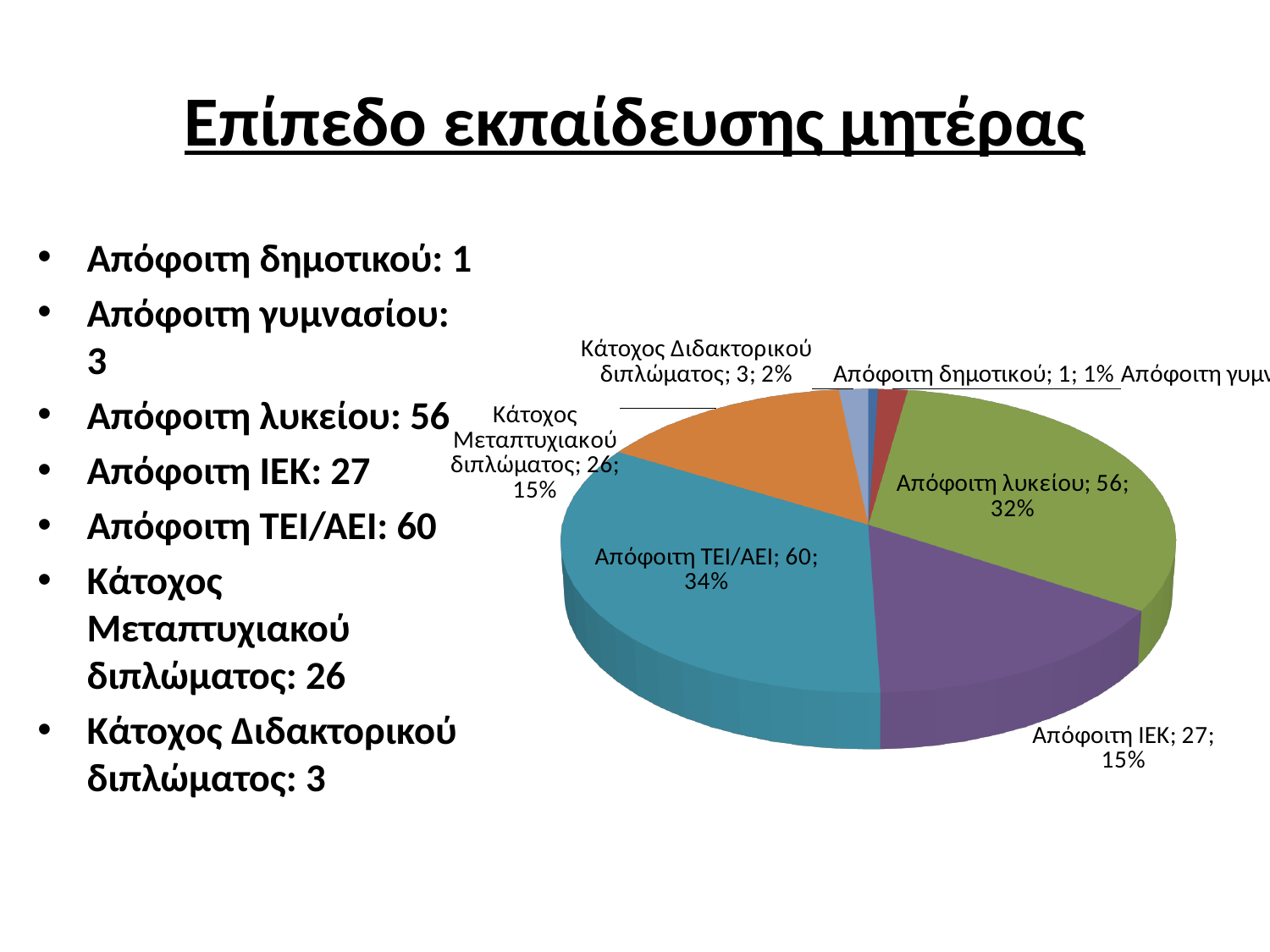
What is the value for Απόφοιτη ΤΕΙ/ΑΕΙ in the pie chart? 60 What percentage share does Κάτοχος Διδακτορικού διπλώματος have in the pie chart? 2% What is the difference between the values for Απόφοιτη ΤΕΙ/ΑΕΙ and Απόφοιτη λυκείου? 4 Which is larger, the value for Απόφοιτη ΙΕΚ or the value for Κάτοχος Μεταπτυχιακού διπλώματος? Απόφοιτη ΙΕΚ Which category has the smallest slice in the pie chart? Απόφοιτη δημοτικού Which category has the largest slice in the pie chart? Απόφοιτη ΤΕΙ/ΑΕΙ What percentage share does Απόφοιτη λυκείου have in the pie chart? 32% What is the value for Κάτοχος Μεταπτυχιακού διπλώματος in the pie chart? 26 What type of chart is shown on the slide? Pie chart How many slices does the pie chart have? 7 What percentage share does Απόφοιτη ΙΕΚ have in the pie chart? 15% What is the title of the slide containing the pie chart? Επίπεδο εκπαίδευσης μητέρας